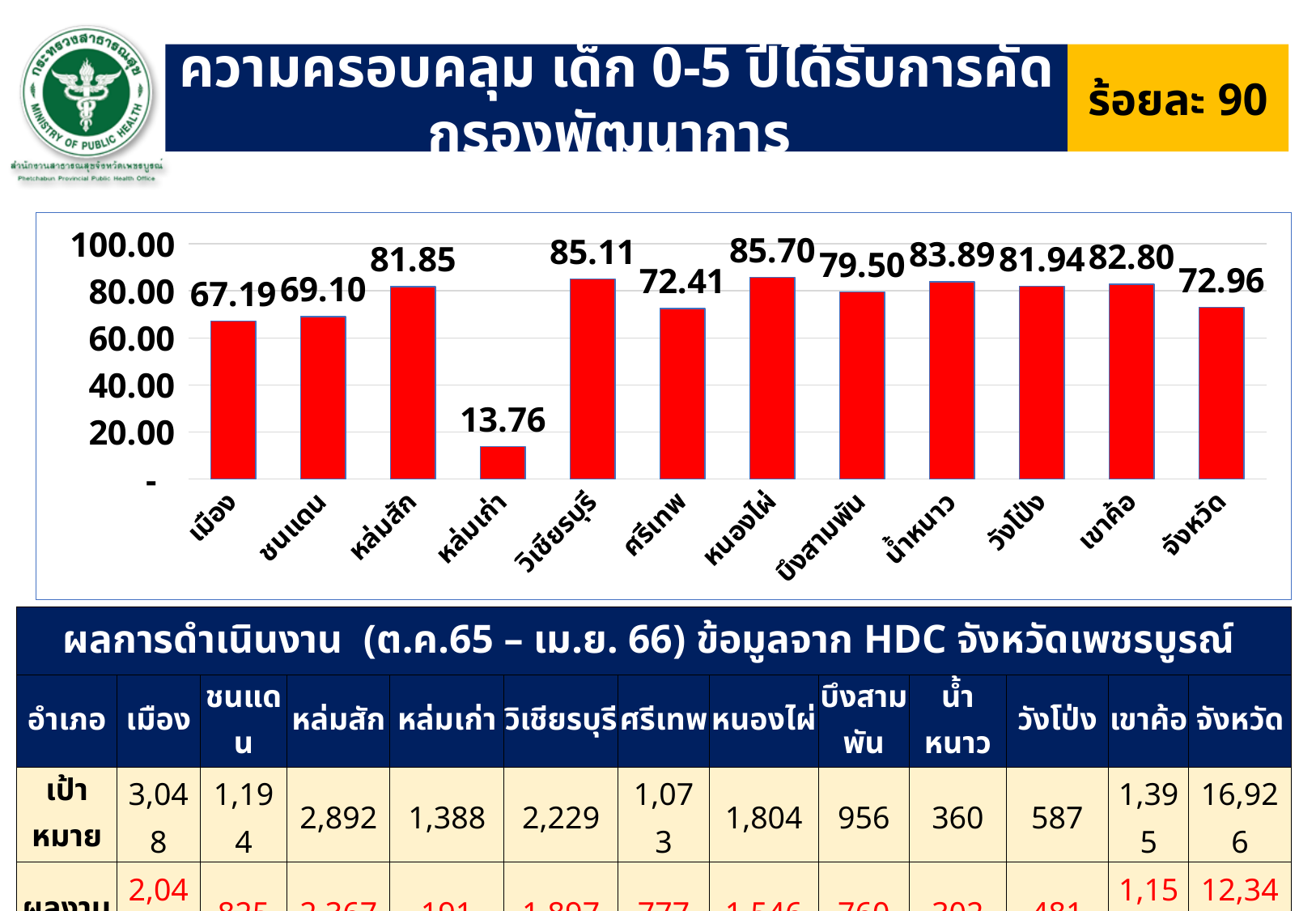
What kind of chart is shown on the slide? bar chart What is the value for จังหวัด in the bar chart? 72.96 Which category has the highest value in the bar chart? หนองไผ่ Which is larger, the value for น้ำหนาว or the value for เขาค้อ? น้ำหนาว What is the difference between the values for ชนแดน and เมือง? 1.91 What is the value for บึงสามพัน in the bar chart? 79.50 What is the value for หล่มสัก in the bar chart? 81.85 What is the difference between the values for หนองไผ่ and หล่มเก่า? 71.94 How many categories are shown on the x axis of the bar chart? 12 Which category has the lowest value in the bar chart? หล่มเก่า What colour are the bars in the chart? red Is the value for ศรีเทพ greater or less than 80.00? less